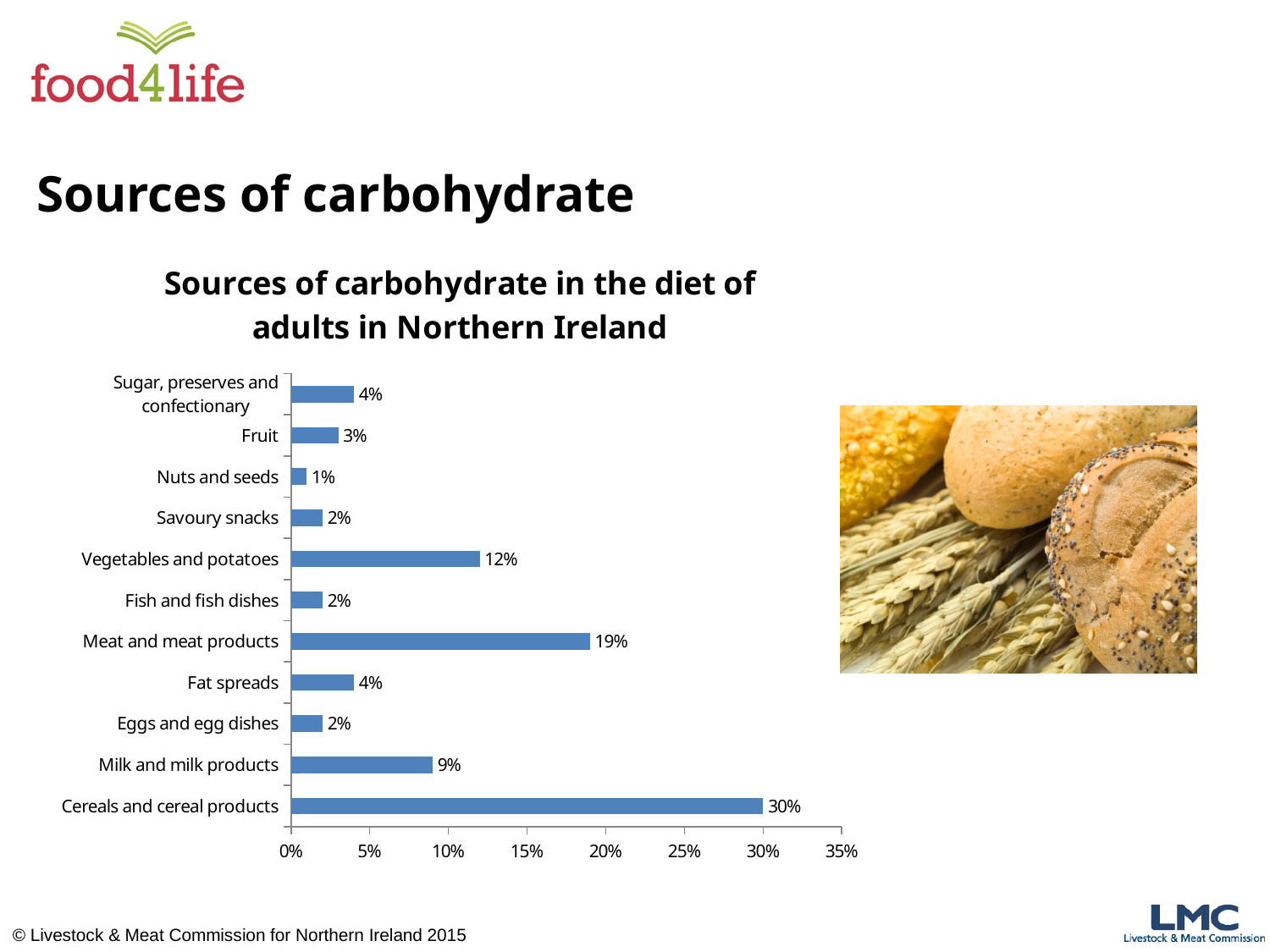
Which is larger, the value for vegetables and potatoes or the value for milk and milk products? Vegetables and potatoes What is the value shown for vegetables and potatoes? 12% How many categories are shown in the chart? 11 What kind of chart is shown on the slide? Bar chart What is the title of the chart? Sources of carbohydrate in the diet of adults in Northern Ireland What is the difference between the values for cereals and cereal products and meat and meat products? 11% What percentage of carbohydrate in the diet of adults in Northern Ireland comes from cereals and cereal products? 30% Which category is the largest source of carbohydrate? Cereals and cereal products What is the value shown for milk and milk products? 9% What is the value shown for meat and meat products? 19% Is the value for meat and meat products greater or less than 15%? greater Which category is the smallest source of carbohydrate? Nuts and seeds